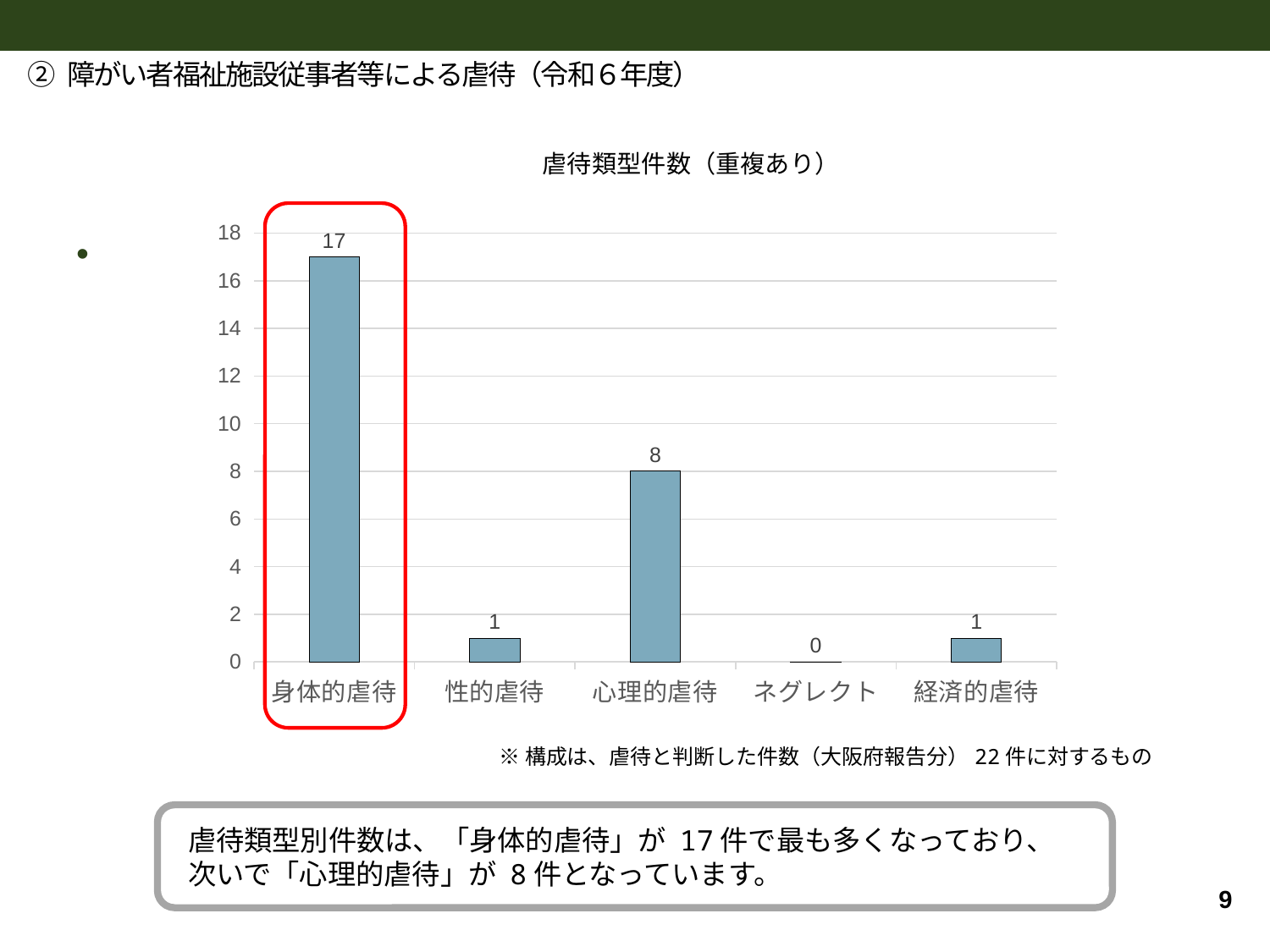
What is the value for 身体的虐待? 17 Which is larger, the value for 心理的虐待 or the value for 経済的虐待? 心理的虐待 What is the value for 心理的虐待? 8 Which category has the highest value? 身体的虐待 What is the title of the chart? 虐待類型件数（重複あり） What is the value for 性的虐待? 1 What is the difference between the values for 身体的虐待 and 心理的虐待? 9 Which category has the lowest value? ネグレクト Is the value for 身体的虐待 greater or less than 10? greater How many categories are shown on the x axis? 5 What kind of chart is shown on the slide? bar chart What is the value for ネグレクト? 0